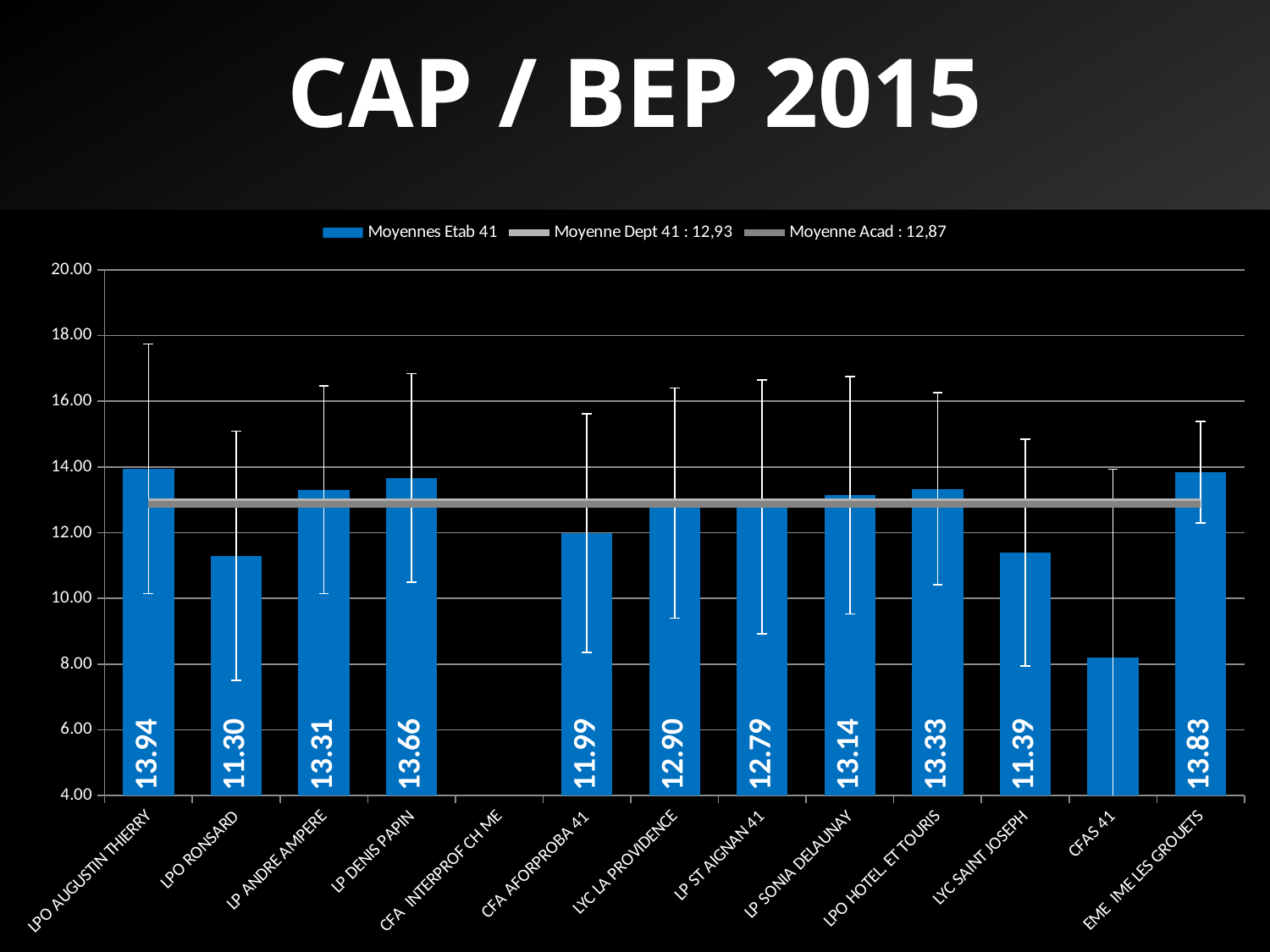
Which category has the lowest bar? CFAS 41 What is the difference between the values for LPO AUGUSTIN THIERRY and LPO RONSARD? 2.64 Is the value for CFAS 41 greater or less than 10.00? less What value does the legend give for Moyenne Dept 41? 12,93 Which category has the highest value? LPO AUGUSTIN THIERRY What is the value for LPO AUGUSTIN THIERRY? 13.94 How many categories are listed on the x axis? 13 Which is larger, the value for LP DENIS PAPIN or the value for LP SONIA DELAUNAY? LP DENIS PAPIN What is the value for LYC SAINT JOSEPH? 11.39 What is the value for LYC LA PROVIDENCE? 12.90 How many series does the legend list? 3 What kind of chart is shown on the slide? bar chart